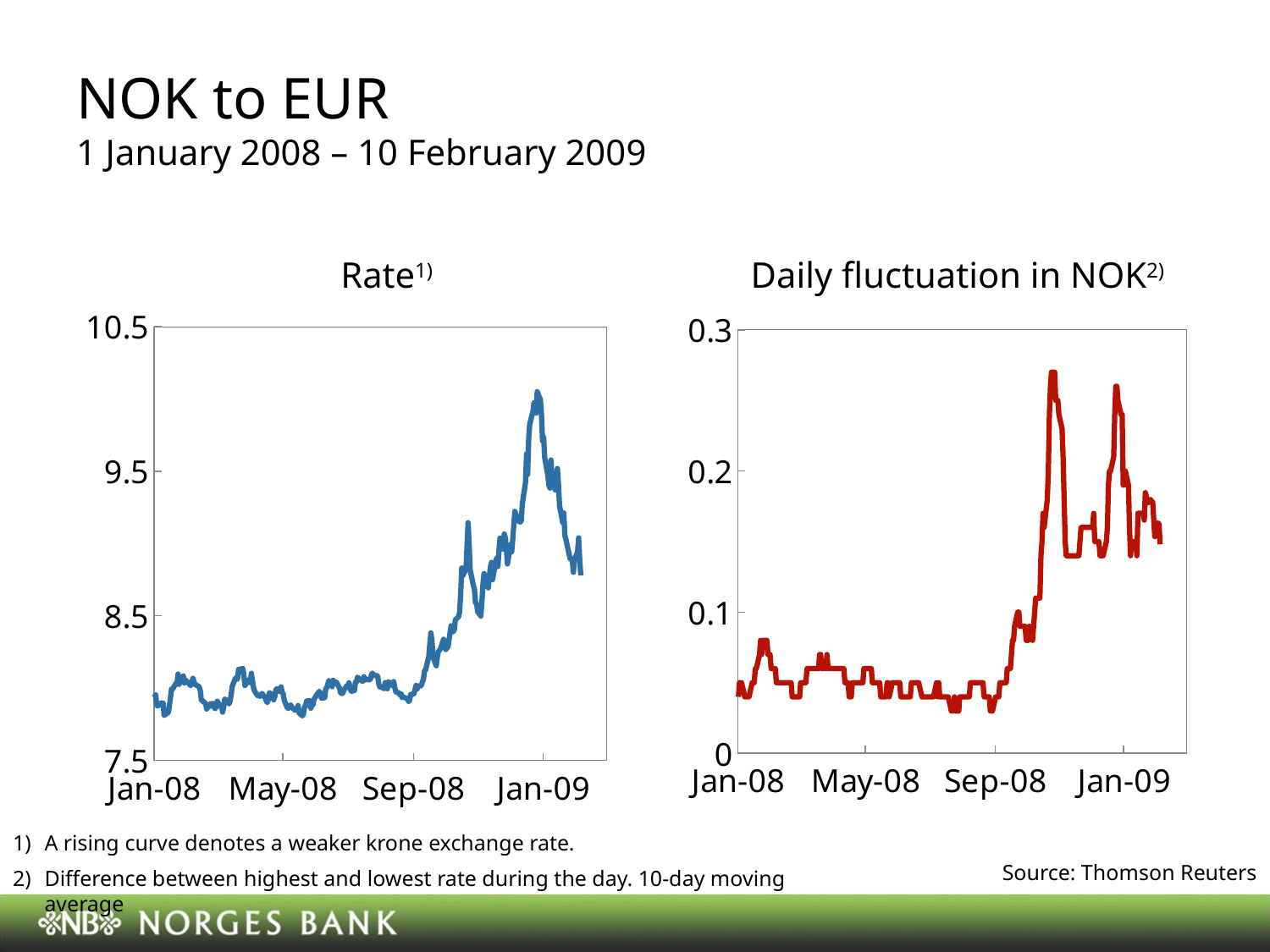
In the "Daily fluctuation in NOK" chart, is the value at Sep-08 greater or less than 0.1? less In the "Rate" chart, is the value at Jan-08 greater or less than 8.5? less In the "Rate" chart, is the value at Sep-08 greater or less than 8.5? less In the "Rate" chart, does the line overall rise or fall from Jan-08 to Jan-09? rise What kind of chart is the left chart titled "Rate"? line chart What colour is the line in the "Daily fluctuation in NOK" chart? red What kind of chart is the right chart titled "Daily fluctuation in NOK"? line chart In the "Daily fluctuation in NOK" chart, does the line overall rise or fall from Jan-08 to Jan-09? rise How many labelled tick marks are on the x axis of the "Rate" chart? 4